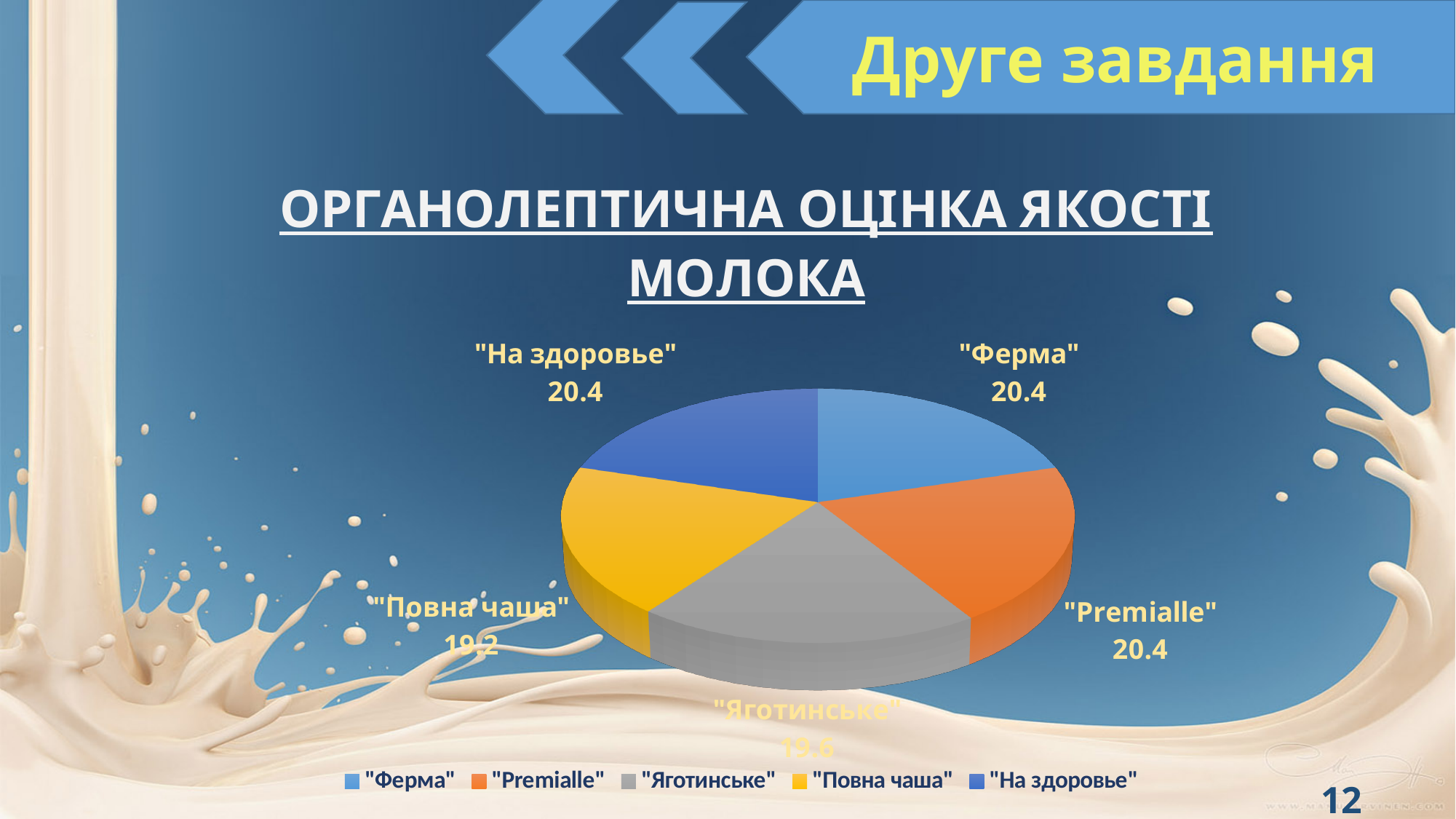
What is the value for "Повна чаша" in the pie chart? 19.2 What kind of chart is shown on the slide? Pie chart What is the difference between the values for "Яготинське" and "Повна чаша"? 0.4 What colour is the "Яготинське" slice in the pie chart? Grey How many categories are shown in the pie chart? 5 What is the value for "Ферма" in the pie chart? 20.4 Which is larger, the value for "Ферма" or the value for "Яготинське"? "Ферма" What is the title of the chart? ОРГАНОЛЕПТИЧНА ОЦІНКА ЯКОСТІ МОЛОКА What is the difference between the values for "Premialle" and "Повна чаша"? 1.2 Which category has the lowest value in the pie chart? "Повна чаша" What is the value for "На здоровье" in the pie chart? 20.4 What is the value for "Яготинське" in the pie chart? 19.6